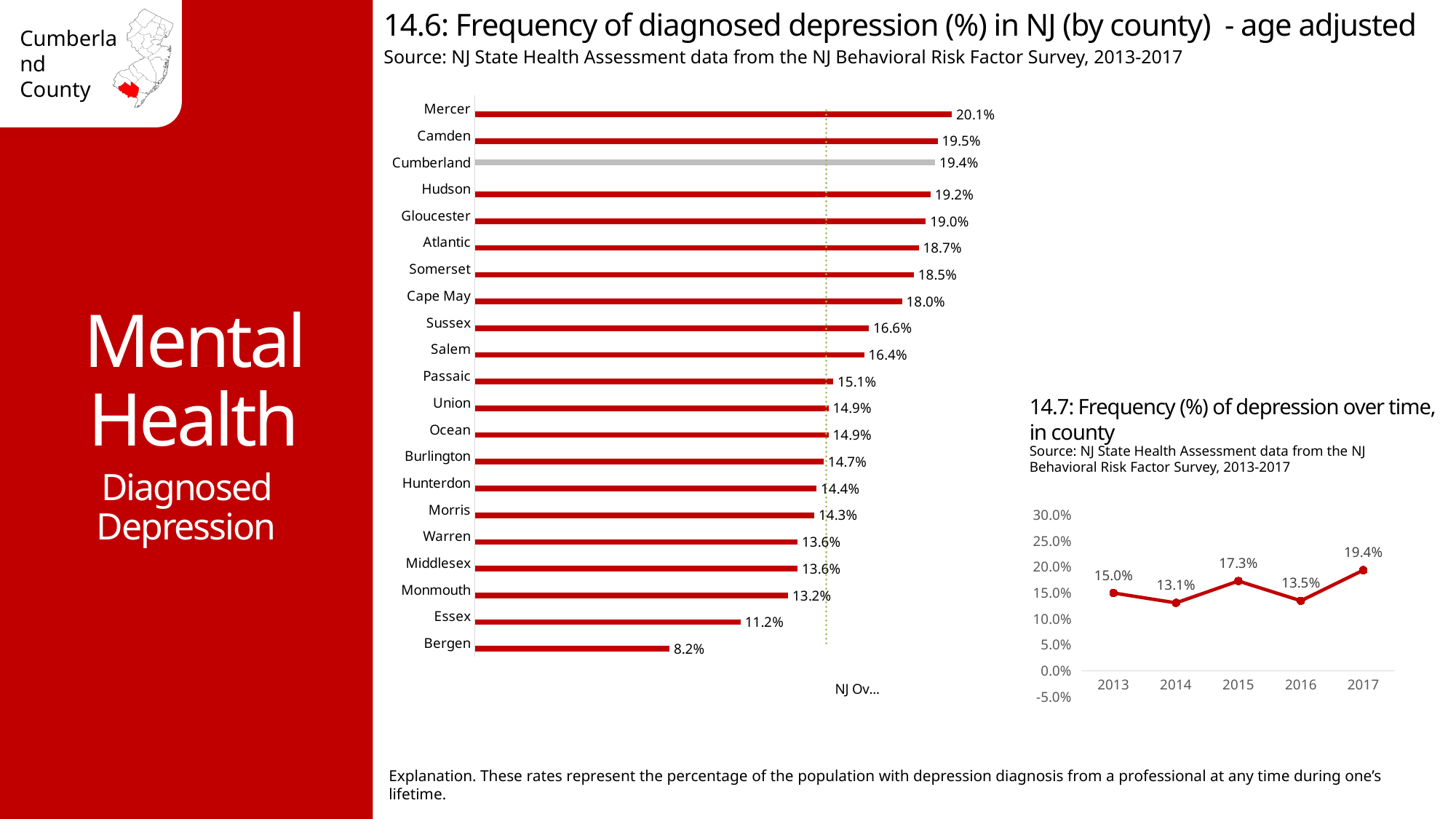
What kind of chart is chart 14.6? Bar chart In chart 14.6, how many counties are shown? 21 In chart 14.6, which county has a higher value, Camden or Hudson? Camden In chart 14.6, what is the difference between the values for Mercer and Bergen? 11.9% In chart 14.7, how many years are plotted? 5 In chart 14.6, what is the frequency of diagnosed depression for Cumberland? 19.4% In chart 14.6, what is the value for Essex? 11.2% In chart 14.7, what is the difference between the values for 2017 and 2014? 6.3% In chart 14.7, which year has the highest frequency of depression? 2017 In chart 14.7, what is the frequency of depression in 2015? 17.3% In chart 14.6, which county has the lowest frequency of diagnosed depression? Bergen In chart 14.6, which county has the highest frequency of diagnosed depression? Mercer